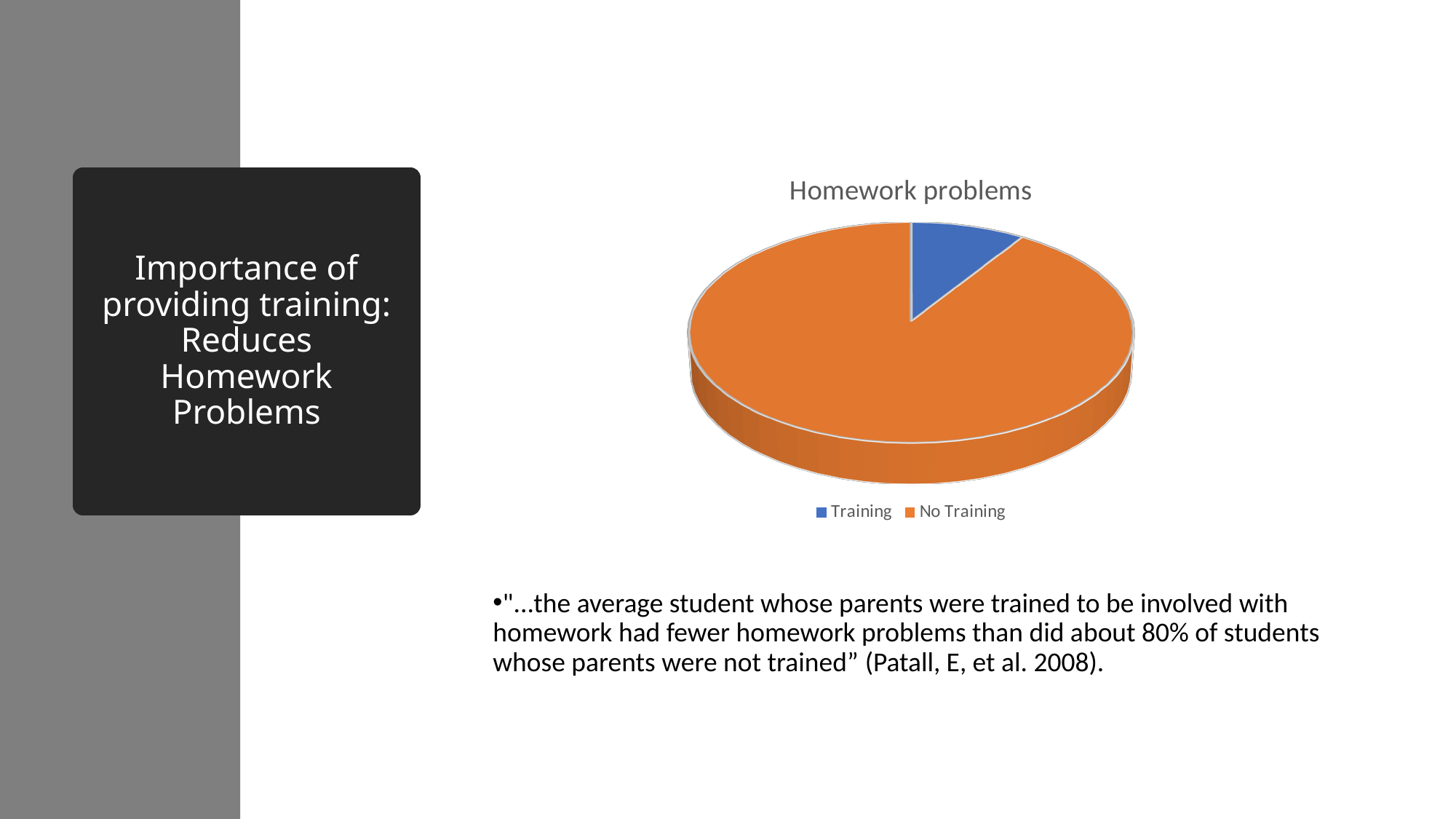
Which slice of the pie chart is the smallest? Training How many entries does the legend list? 2 What kind of chart is shown on the slide? pie chart What is the title of the chart? Homework problems Which slice of the pie chart is the largest? No Training Does the Training slice take up more or less than half of the pie? less How many slices does the pie chart have? 2 Which slice is larger, Training or No Training? No Training What colour is the No Training slice? orange